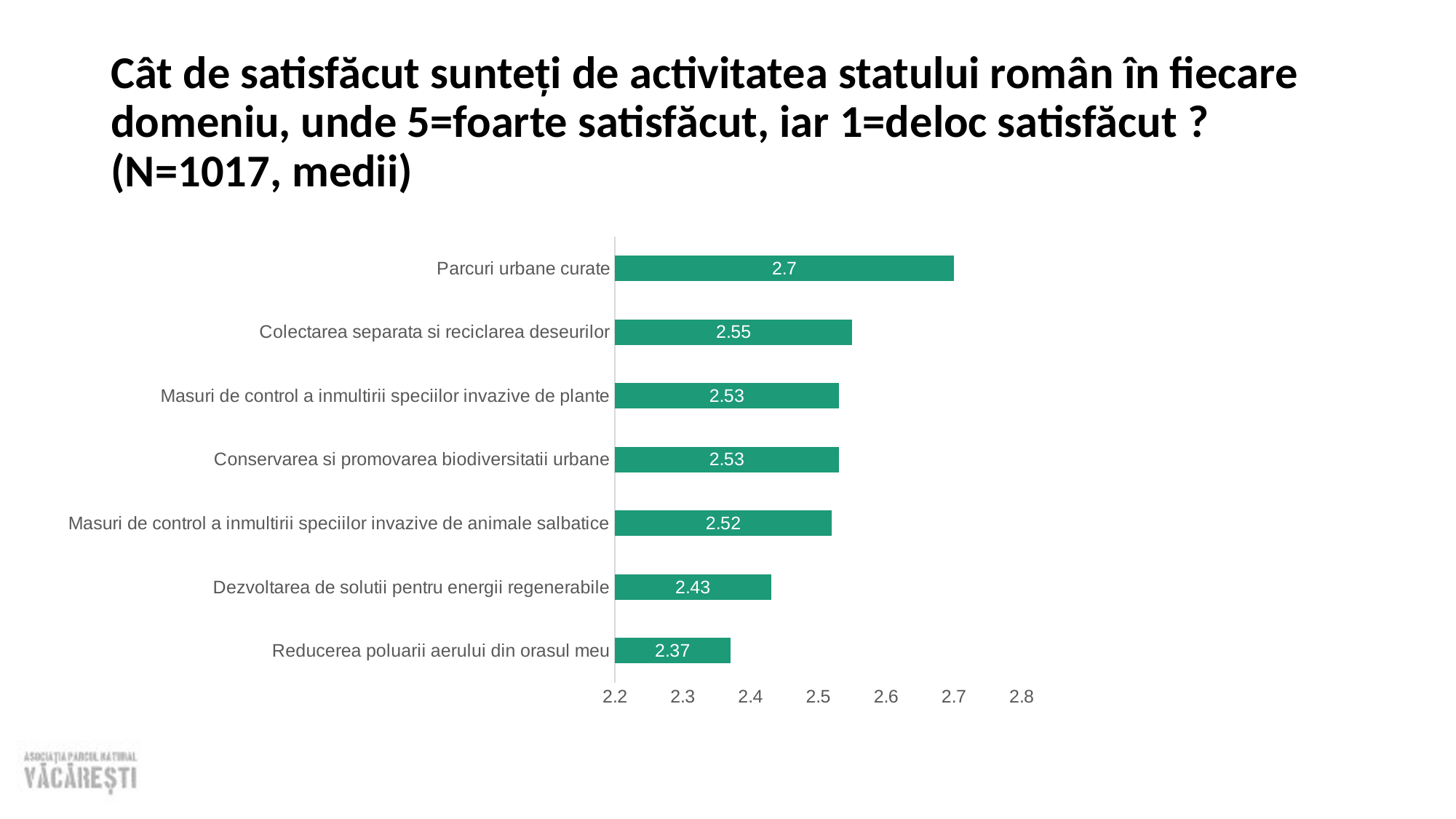
What is the value for Dezvoltarea de solutii pentru energii regenerabile? 2.43 Which is larger, the value for Colectarea separata si reciclarea deseurilor or the value for Dezvoltarea de solutii pentru energii regenerabile? Colectarea separata si reciclarea deseurilor Is the value for Masuri de control a inmultirii speciilor invazive de animale salbatice greater or less than 2.4? greater What is the value for Colectarea separata si reciclarea deseurilor? 2.55 What is the sample size (N) stated in the chart title? 1017 Which category has the highest value? Parcuri urbane curate Which category has the lowest value? Reducerea poluarii aerului din orasul meu What is the value for Reducerea poluarii aerului din orasul meu? 2.37 What kind of chart is shown on the slide? bar chart What is the value for Parcuri urbane curate? 2.7 How many categories are shown in the chart? 7 What is the difference between the values for Parcuri urbane curate and Reducerea poluarii aerului din orasul meu? 0.33